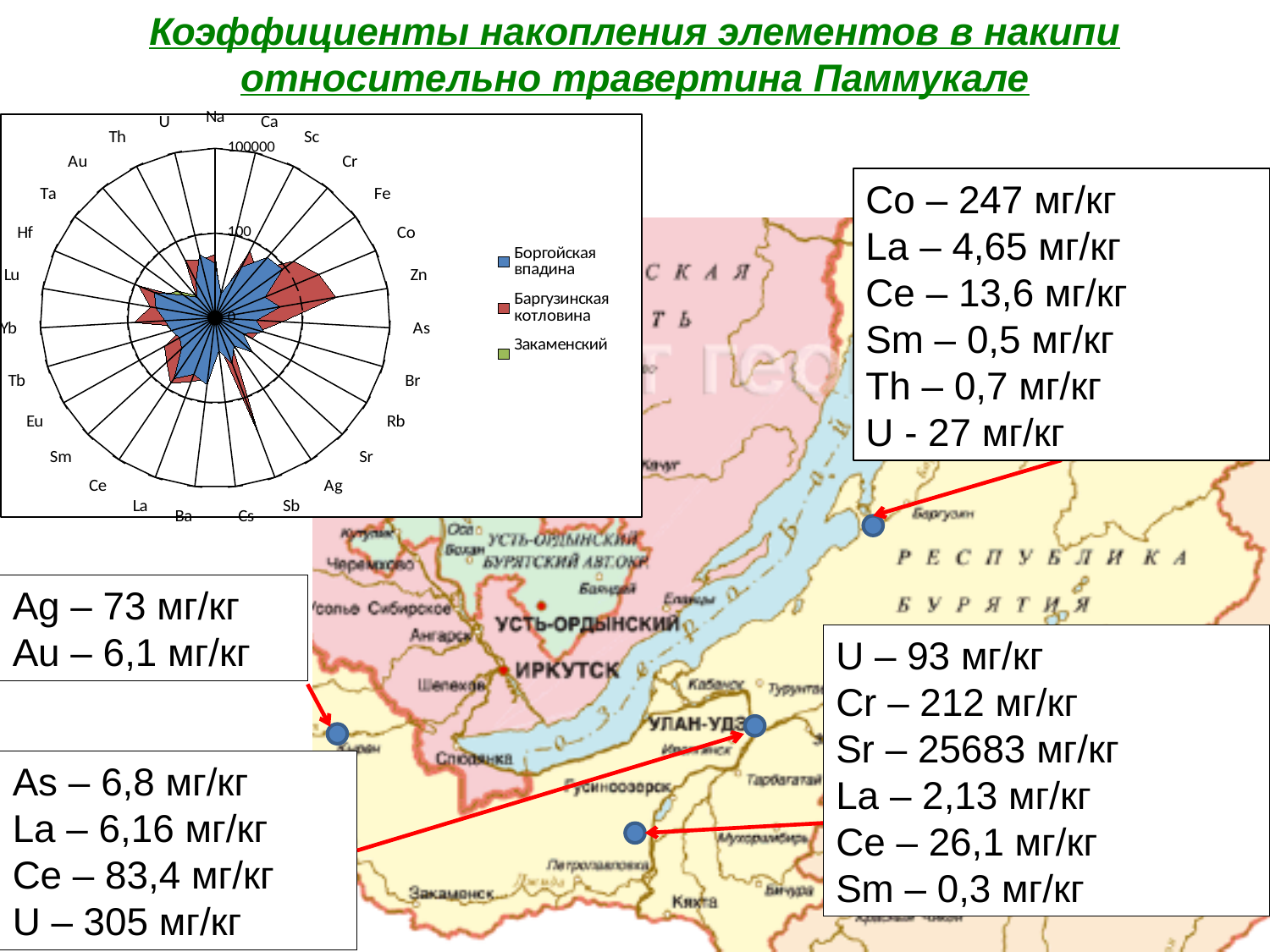
Is the value for As for the Баргузинская котловина series greater or less than 100? less How many series does the legend of the radar chart list? 3 Which series in the radar chart is drawn in red? Баргузинская котловина Is the value for Ta for the Боргойская впадина series greater or less than 100? less Is the value for Zn for the Баргузинская котловина series greater or less than 100? greater What kind of chart is shown on the slide? radar chart Which series in the radar chart is drawn in blue? Боргойская впадина How many element categories are plotted around the radar chart? 27